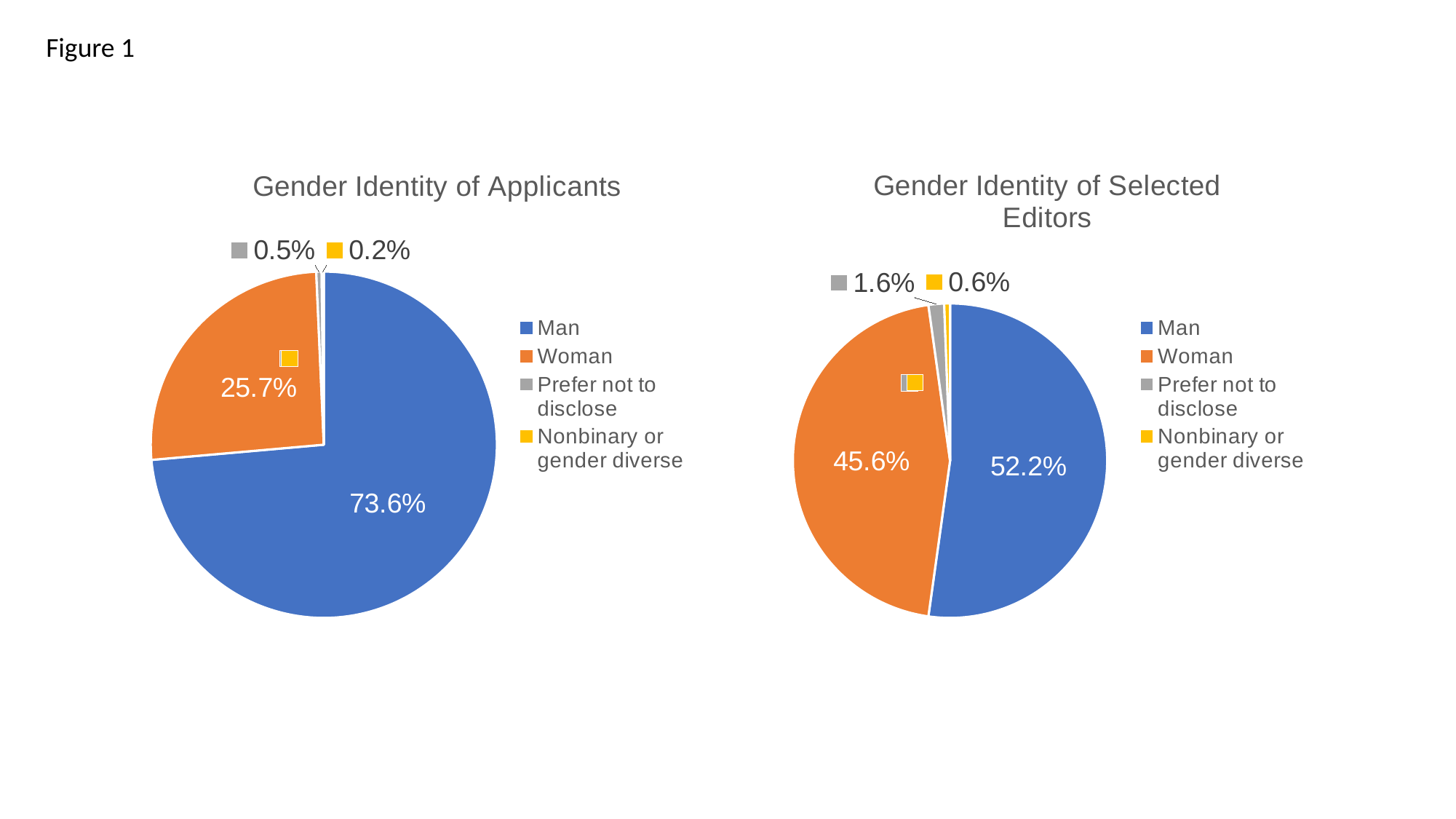
In the 'Gender Identity of Selected Editors' chart, what is the difference between the Man and Woman shares? 6.6% In the 'Gender Identity of Selected Editors' chart, what share of selected editors are Nonbinary or gender diverse? 0.6% In the 'Gender Identity of Applicants' chart, what share of applicants chose 'Prefer not to disclose'? 0.5% Which is larger: the Woman share in the 'Gender Identity of Applicants' chart or the Woman share in the 'Gender Identity of Selected Editors' chart? Gender Identity of Selected Editors In the 'Gender Identity of Selected Editors' chart, which category has the largest slice? Man How many categories does the 'Gender Identity of Applicants' chart show? 4 In the 'Gender Identity of Selected Editors' chart, what share of selected editors are Woman? 45.6% What type of chart is 'Gender Identity of Selected Editors'? Pie chart In the 'Gender Identity of Applicants' chart, what share of applicants are Woman? 25.7% In the 'Gender Identity of Applicants' chart, what share of applicants are Man? 73.6% In the 'Gender Identity of Applicants' chart, what colour represents the Woman category? Orange In the 'Gender Identity of Applicants' chart, which category has the smallest slice? Nonbinary or gender diverse